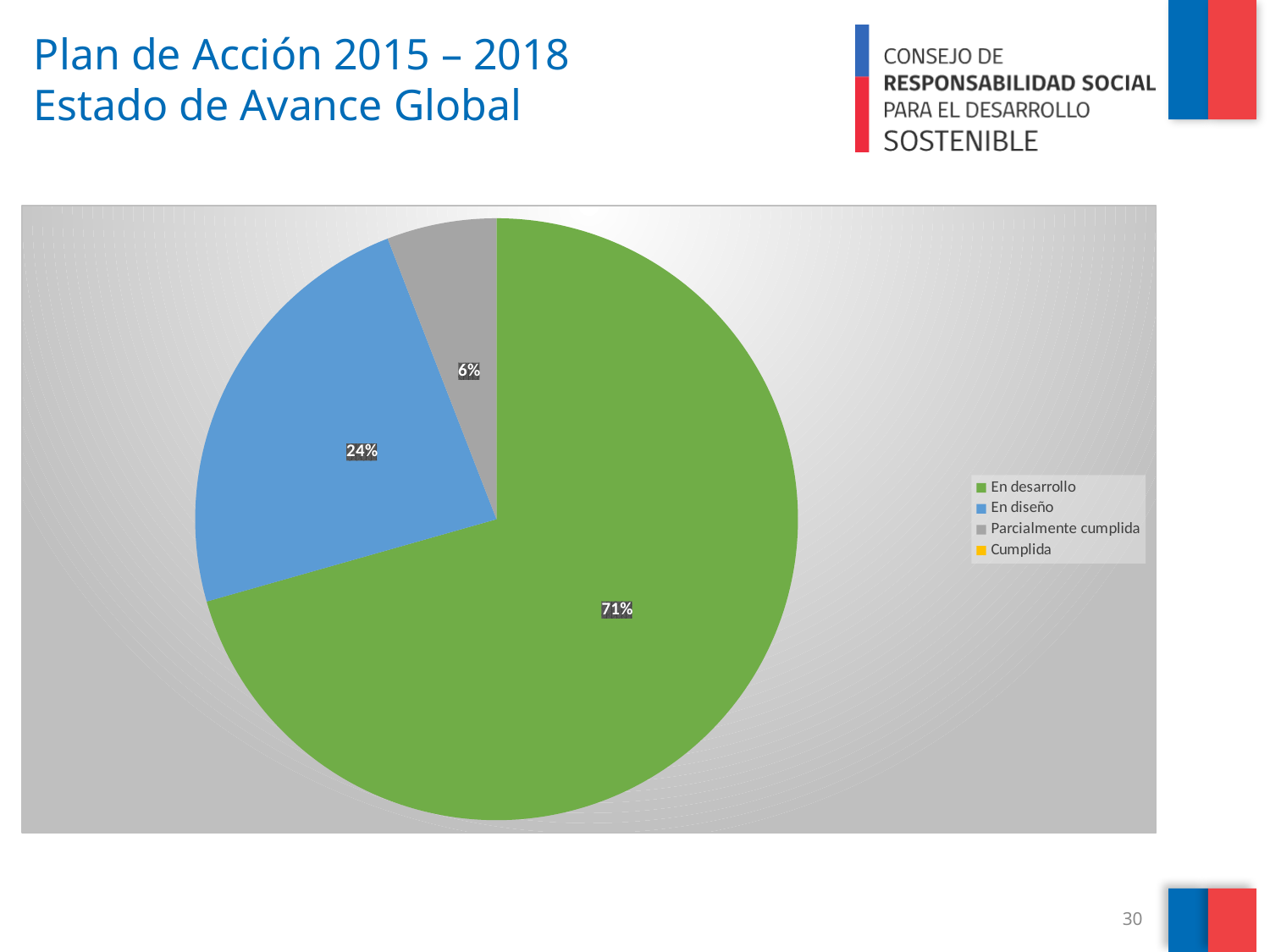
What percentage of the pie is labelled "En desarrollo"? 71% What is the combined share of the "En diseño" and "Parcialmente cumplida" slices? 30% What colour is the "En diseño" slice? blue Which category with a visible slice has the smallest share of the pie? Parcialmente cumplida Which legend entry has no visible slice in the pie? Cumplida What is the difference in percentage points between the "En desarrollo" slice and the "En diseño" slice? 47 Which slice is larger, "En diseño" or "Parcialmente cumplida"? En diseño What percentage of the pie is labelled "Parcialmente cumplida"? 6% Which category has the largest slice of the pie? En desarrollo What percentage of the pie is labelled "En diseño"? 24% How many entries does the legend list? 4 What kind of chart is shown on the slide? pie chart